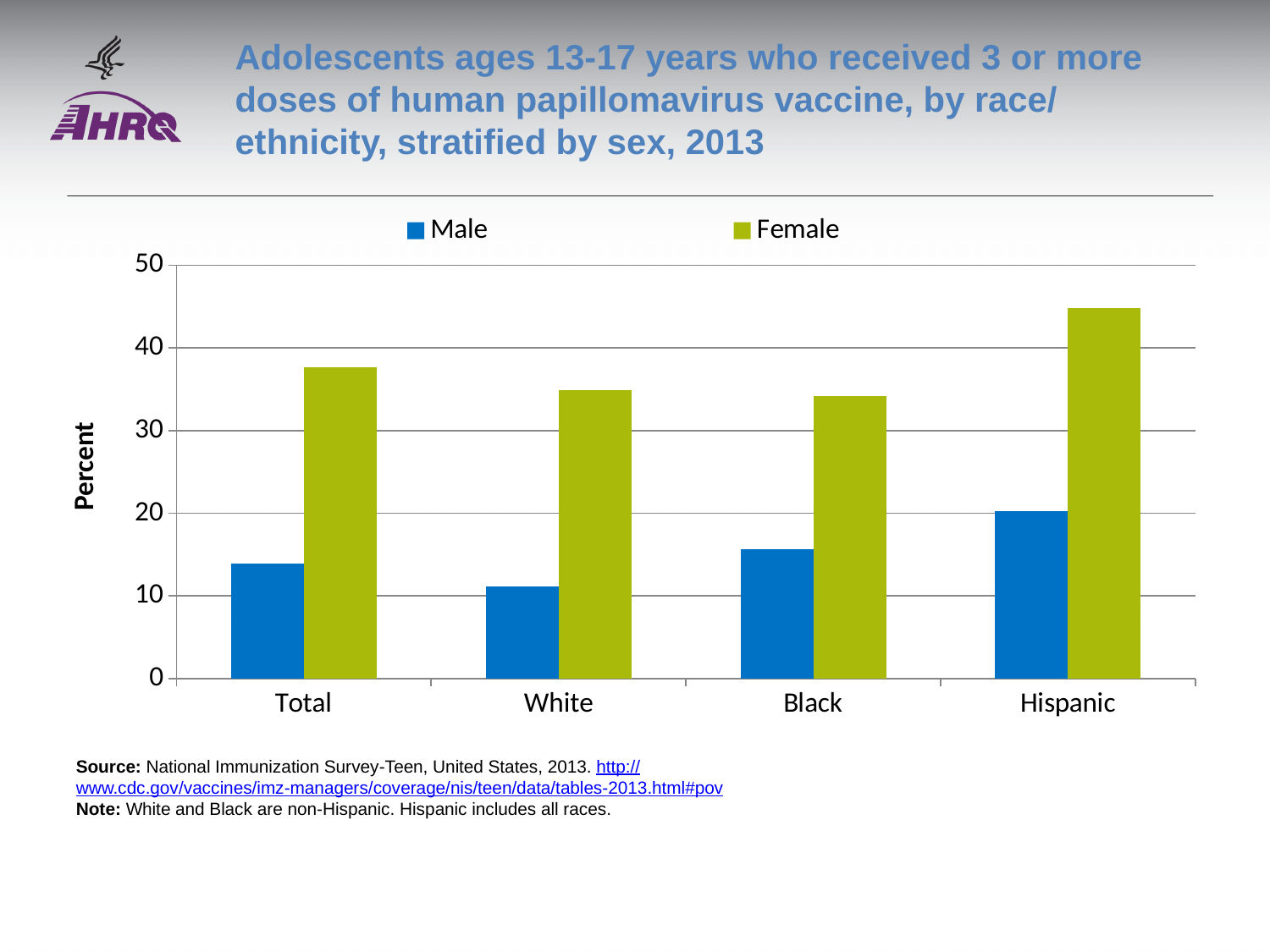
Is the Male value for White greater or less than 10? greater What type of chart is shown on the slide? bar chart Is the Male value for Black greater or less than 20? less Which category has the lowest Male value? White What is the label on the y axis? Percent Which category has the highest Female value? Hispanic Is the Female value for Total greater or less than 40? less How many race/ethnicity categories are shown on the x axis? 4 How many series does the legend list? 2 For Black adolescents, which is larger, the Male value or the Female value? Female Which category has the highest Male value? Hispanic